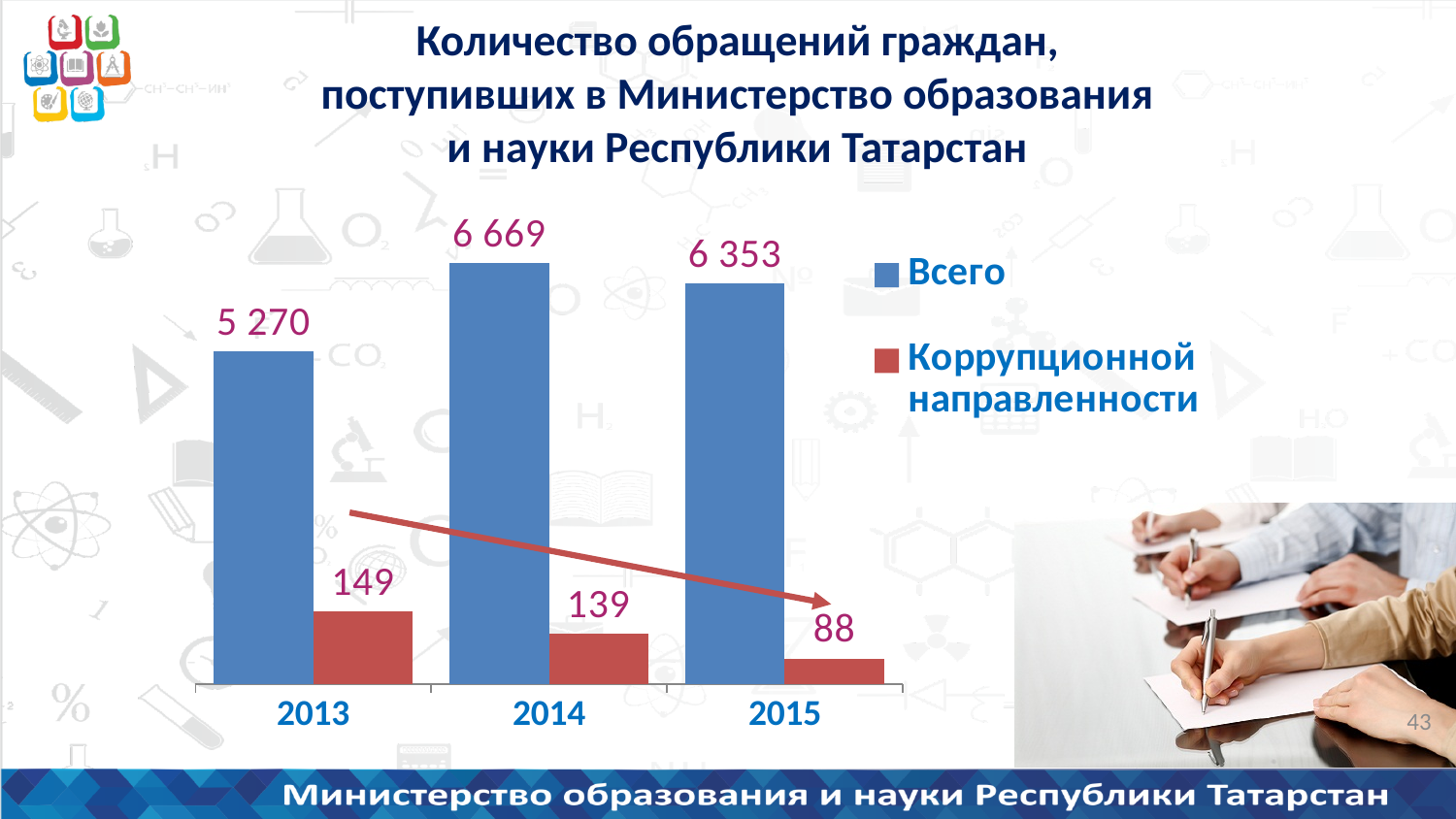
What is the value of the 'Всего' series for 2014? 6 669 Which year has the highest value for the 'Всего' series? 2014 How many series does the legend list? 2 What is the difference between the 'Коррупционной направленности' values for 2013 and 2014? 10 What is the value of the 'Коррупционной направленности' series for 2015? 88 What kind of chart is shown on the slide? Bar chart Does the 'Коррупционной направленности' series rise or fall from 2013 to 2015? Fall What is the difference between the 'Всего' values for 2014 and 2015? 316 How many years are shown on the x axis? 3 Which is larger: the 'Всего' value for 2013 or for 2015? 2015 What is the value of the 'Всего' series for 2013? 5 270 Which year has the lowest value for the 'Коррупционной направленности' series? 2015